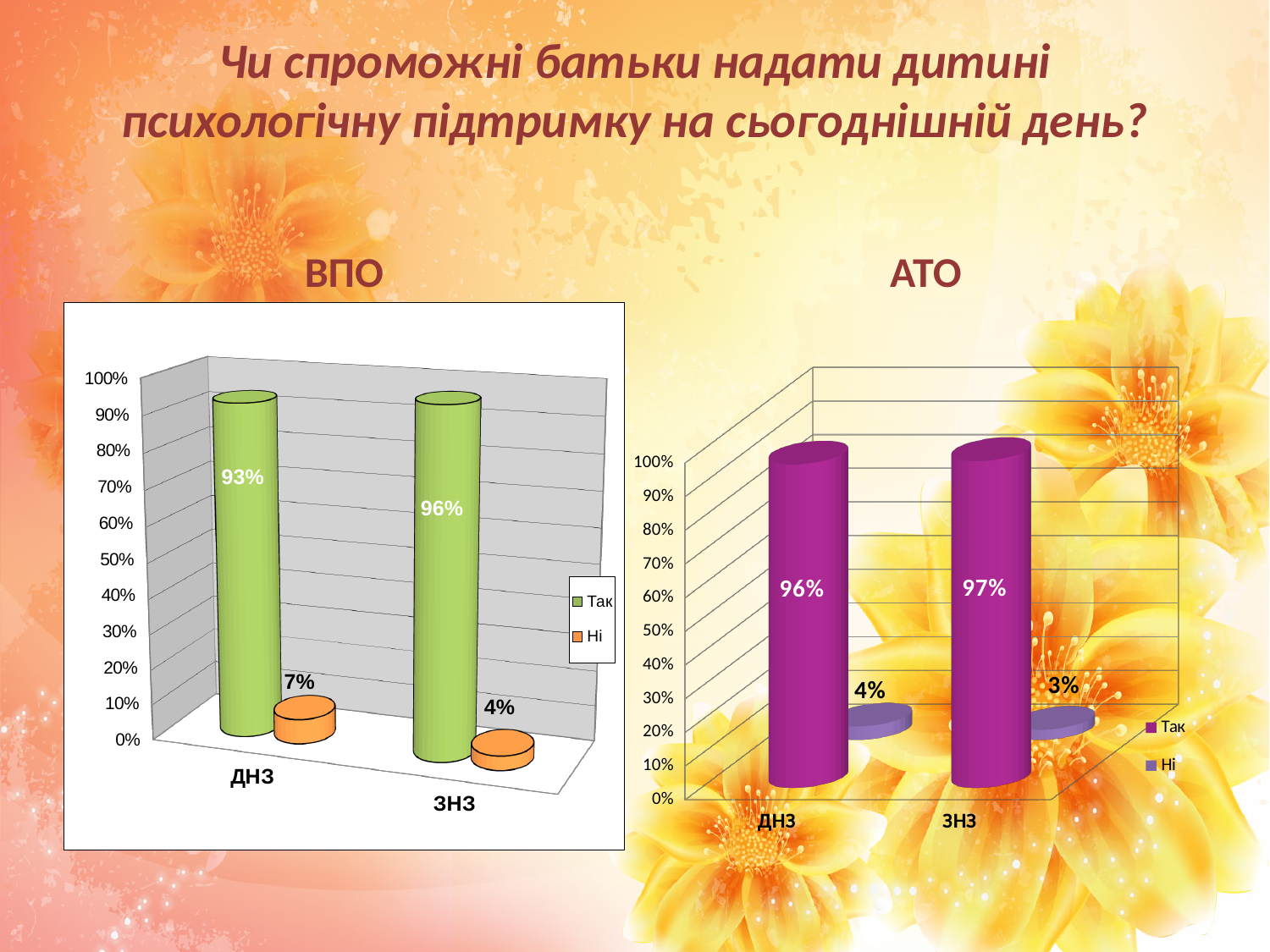
In the АТО chart, what is the difference between the Так values for ЗНЗ and ДНЗ? 1% In the АТО chart, what is the value of Ні for ДНЗ? 4% In the ВПО chart, what is the value of Так for ДНЗ? 93% In the ВПО chart, what is the difference between Так and Ні for ДНЗ? 86% How many categories are shown on the x axis of the АТО chart? 2 In the АТО chart, which category has the lower Ні value? ЗНЗ How many series does the legend of the ВПО chart list? 2 In the ВПО chart, which category has the higher Так value, ДНЗ or ЗНЗ? ЗНЗ What kind of chart is the АТО chart? bar chart What colour are the Так bars in the ВПО chart? green In the ВПО chart, what is the value of Ні for ЗНЗ? 4% In the АТО chart, what is the value of Так for ЗНЗ? 97%